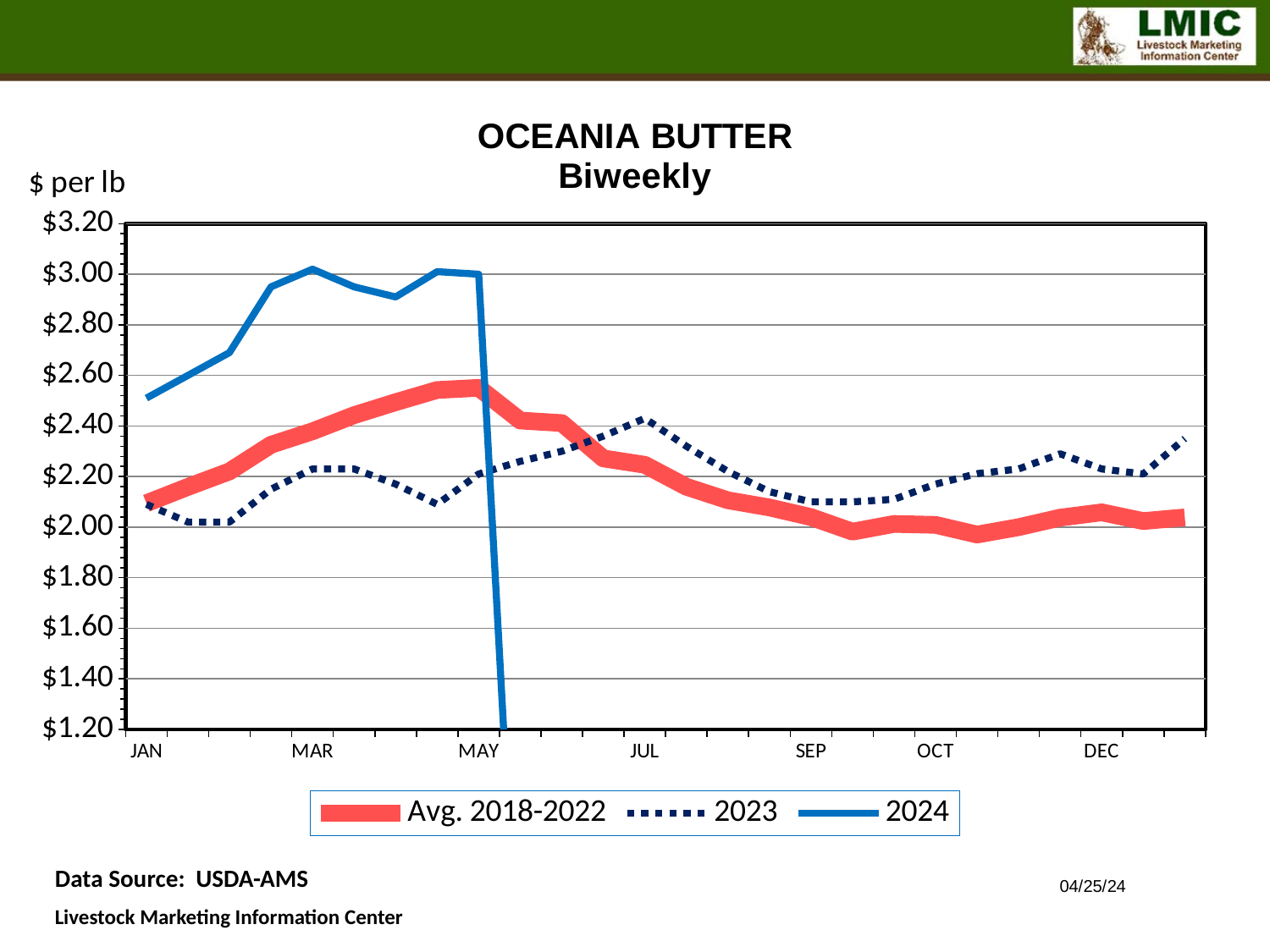
What unit is shown on the y-axis label? $ per lb Is the 2024 value in JAN greater or less than $2.40? greater What is the title of the chart? OCEANIA BUTTER Biweekly Is the 2023 value in JAN greater or less than $2.20? less Does the 2024 line rise or fall from JAN to MAR? rise In JAN, which series has the higher value: 2024 or Avg. 2018-2022? 2024 How many series does the legend list? 3 Is the Avg. 2018-2022 value in DEC greater or less than $2.20? less In JUL, which series has the higher value: 2023 or Avg. 2018-2022? 2023 What kind of chart is shown on the slide? line chart